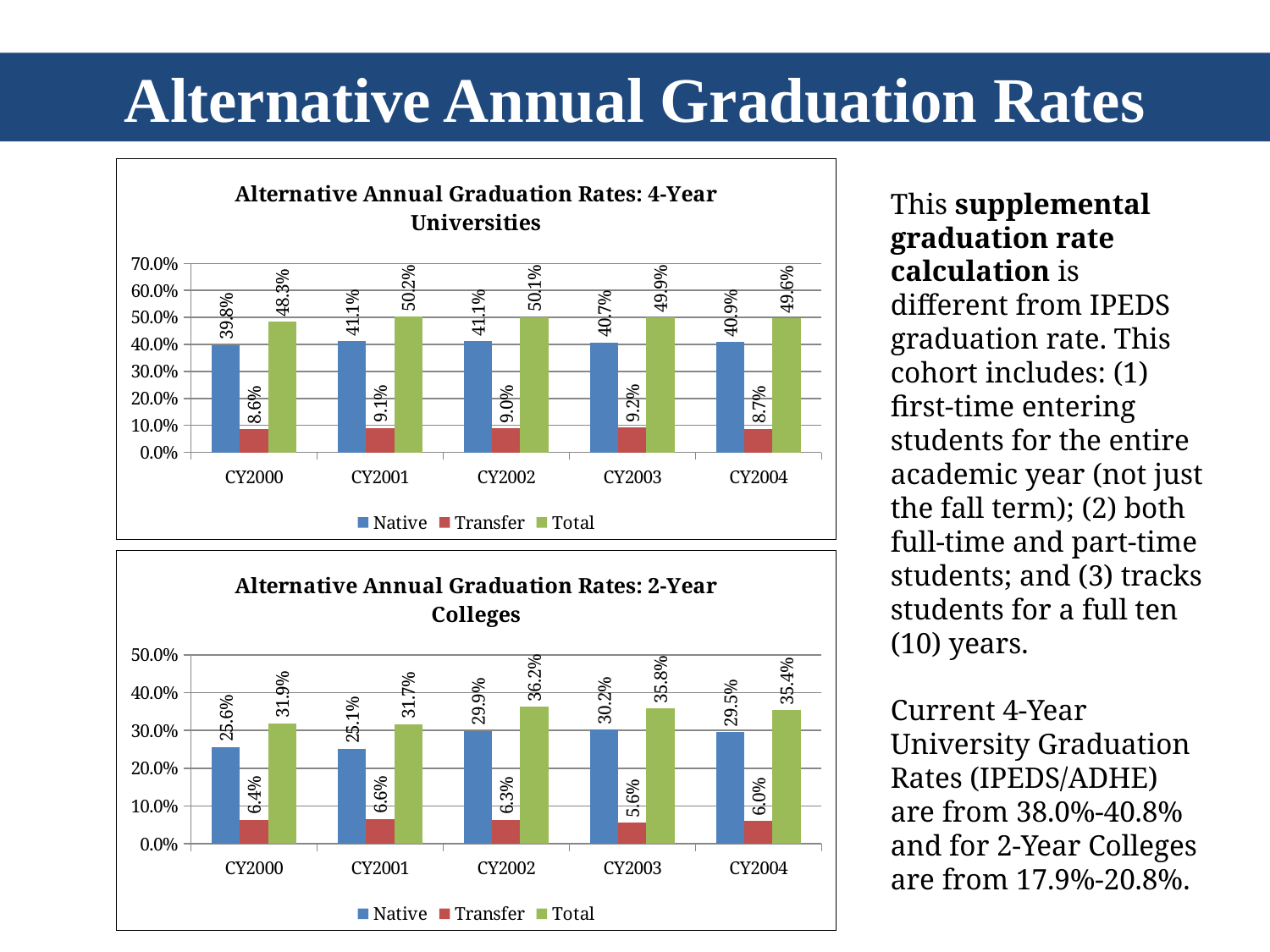
In the 2-Year Colleges chart, is the Native value for CY2002 larger than the Native value for CY2000? Yes In the 2-Year Colleges chart, which year has the highest Total value? CY2002 In the 4-Year Universities chart, what is the difference between the Total and Native values for CY2004? 8.7% In the 4-Year Universities chart, what is the Total value for CY2001? 50.2% In the 4-Year Universities chart, which year has the highest Transfer value? CY2003 In the 2-Year Colleges chart, what is the Transfer value for CY2003? 5.6% In the 2-Year Colleges chart, which year has the lowest Native value? CY2001 What kind of chart is the 2-Year Colleges chart? Bar chart In the 2-Year Colleges chart, how many years are shown on the x axis? 5 In the 4-Year Universities chart, what colour represents the Total series? Green In the 4-Year Universities chart, how many series does the legend list? 3 In the 4-Year Universities chart, what is the Native value for CY2000? 39.8%